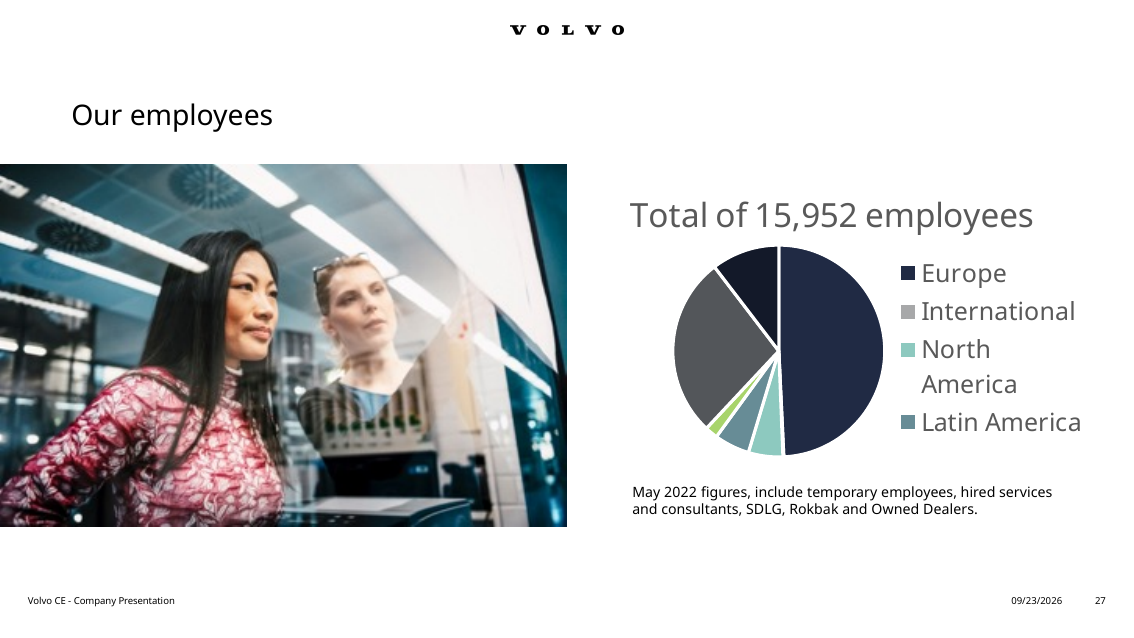
Which slice is larger, Europe or International? Europe Which slice is larger, Europe or Latin America? Europe How many entries does the legend of the pie chart list? 4 What kind of chart is shown on the slide? Pie chart According to the chart title, what is the total number of employees? 15,952 Which region has the largest slice of the pie chart? Europe What is the title of the pie chart? Total of 15,952 employees From which month and year are the figures in the chart, according to the note below it? May 2022